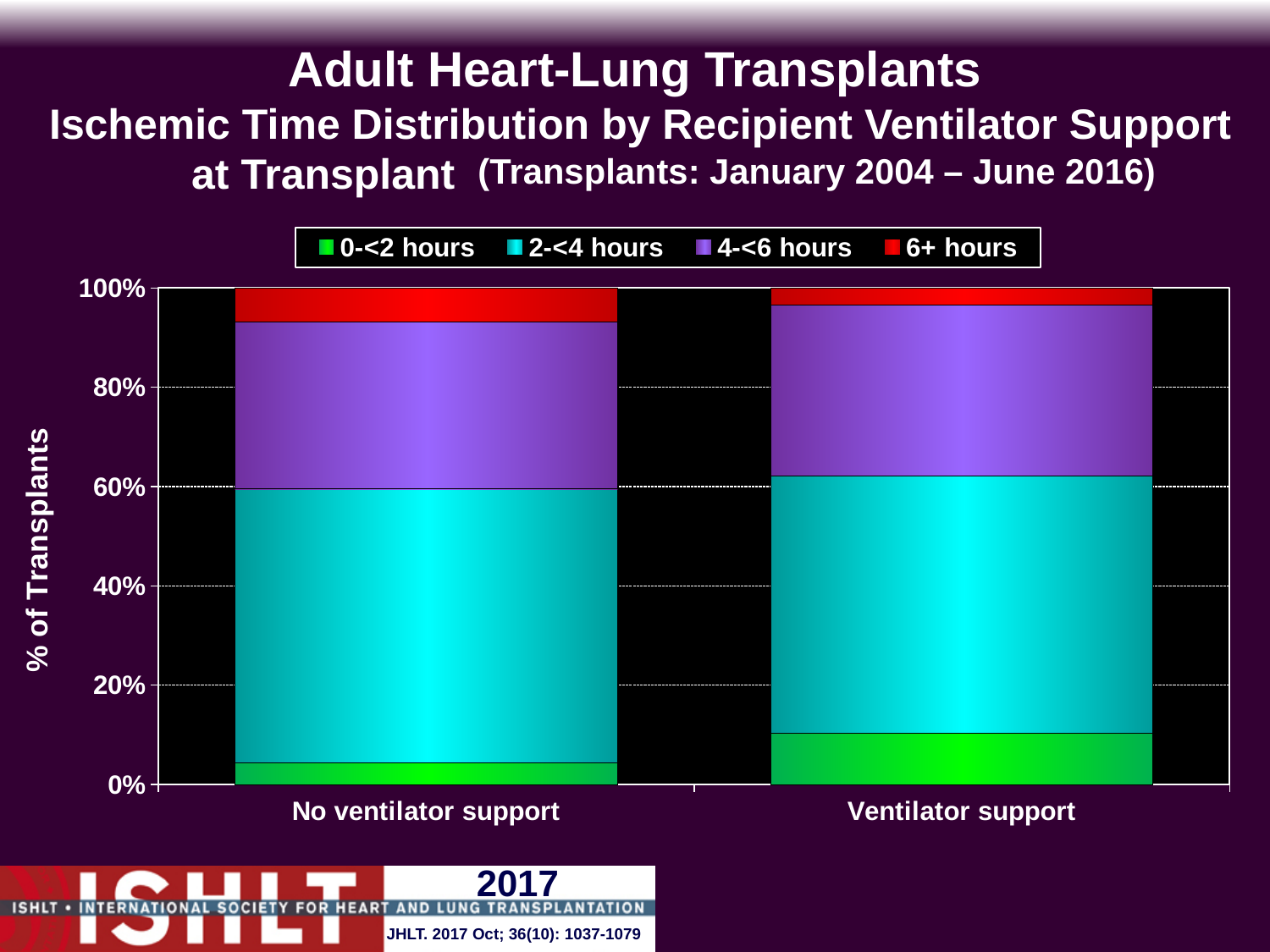
What is the label of the y axis? % of Transplants How many series does the legend list? 4 Is the 0-<2 hours share for Ventilator support greater or less than 20%? less Which series makes up the largest share of the No ventilator support bar? 2-<4 hours Is the 0-<2 hours share for No ventilator support greater or less than 20%? less Which category has the larger 6+ hours share, No ventilator support or Ventilator support? No ventilator support What are the two categories on the x axis? No ventilator support, Ventilator support What is the total height of the stacked bar for No ventilator support? 100% How many categories are shown on the x axis? 2 Is the 6+ hours share for No ventilator support greater or less than 20%? less Which category has the larger 0-<2 hours share, No ventilator support or Ventilator support? Ventilator support What kind of chart is shown on the slide? Stacked bar chart